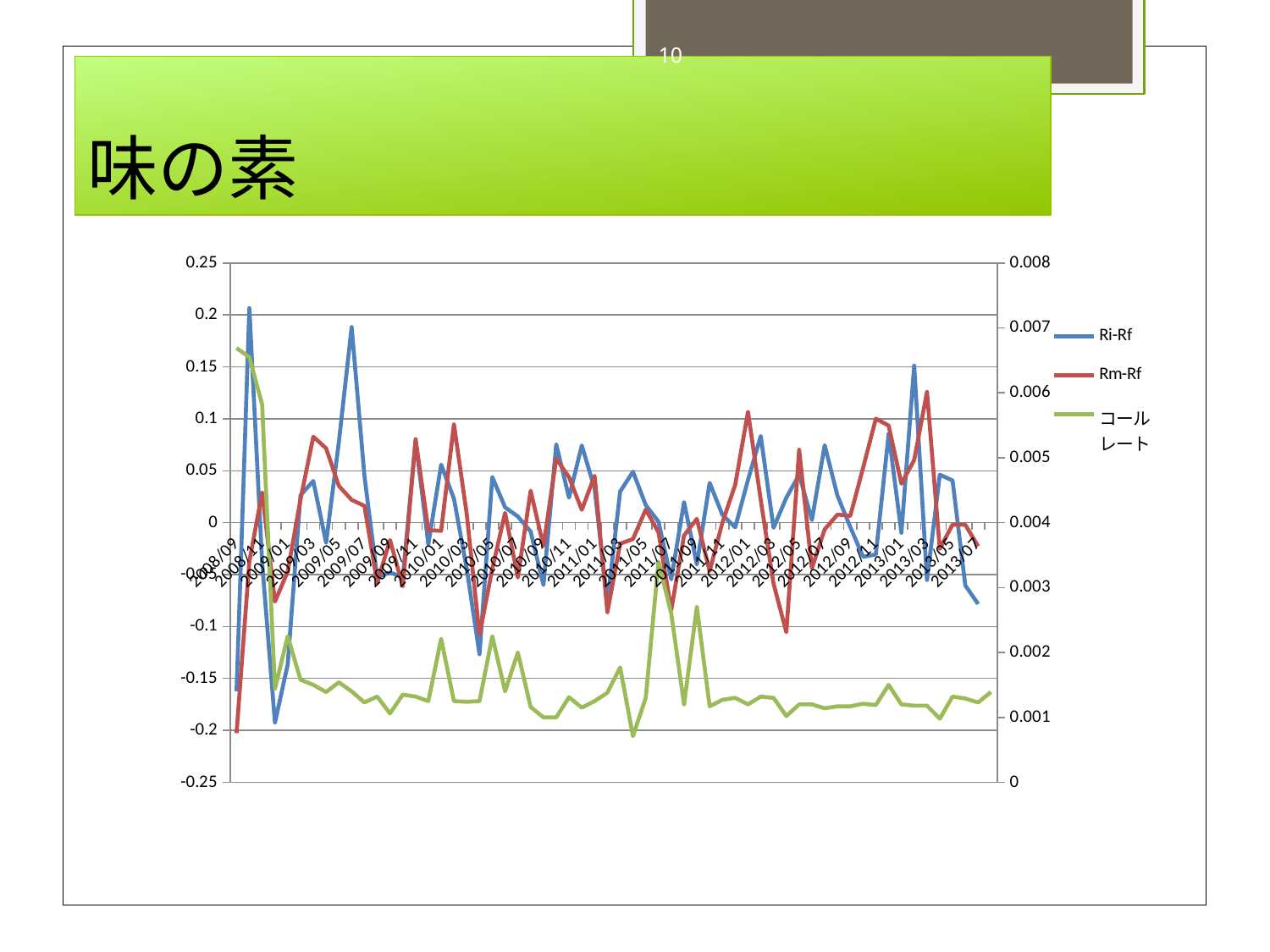
At 2008/09, which series is higher on the left axis, Ri-Rf or Rm-Rf? Ri-Rf Is the value of コールレート at 2008/09 greater or less than 0.006 on the right axis? greater Does the コールレート series generally rise or fall from 2008/09 to 2013/07? fall What kind of chart is shown on the slide? line chart Is the value of Rm-Rf at 2008/09 greater or less than -0.15? less Is the value of Ri-Rf at 2009/07 greater or less than 0.15? less How many series does the legend list? 3 What is the title of the slide containing the chart? 味の素 What are the names of the series listed in the legend? Ri-Rf, Rm-Rf, コールレート At which x-axis date does Rm-Rf reach its lowest value? 2008/09